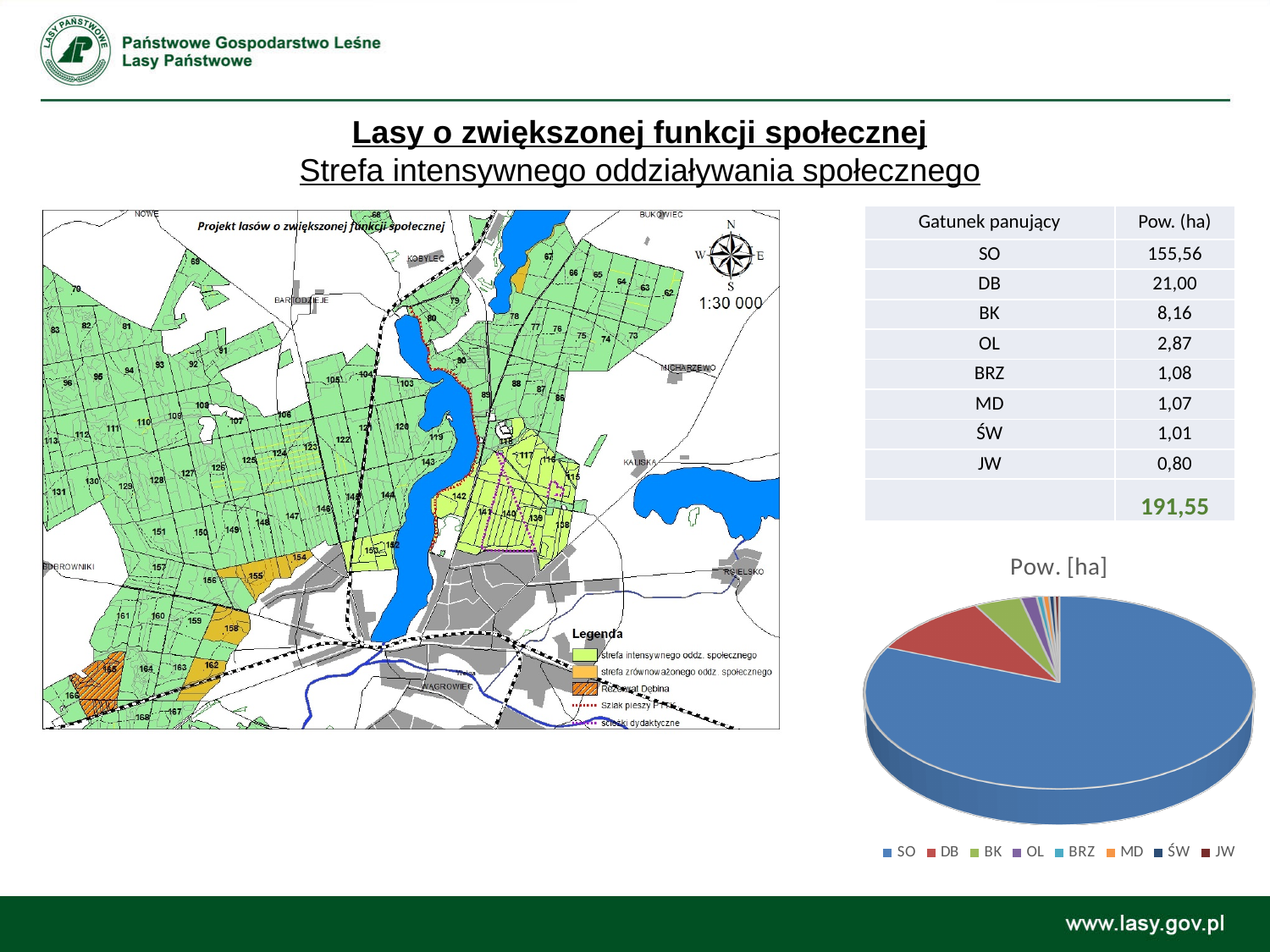
What is the area (Pow. ha) for BK? 8,16 Which category has the smallest slice in the pie chart? JW What is the total area across all categories? 191,55 What kind of chart is shown on the slide? pie chart What is the area (Pow. ha) for DB? 21,00 What colour is the largest slice (SO) in the pie chart? blue What is the difference between the area for SO and the area for DB? 134,56 Which category has the largest slice in the pie chart? SO How many categories does the pie chart's legend list? 8 What is the area (Pow. ha) for SO? 155,56 Which is larger, the area for DB or the area for BK? DB What is the title of the pie chart? Pow. [ha]